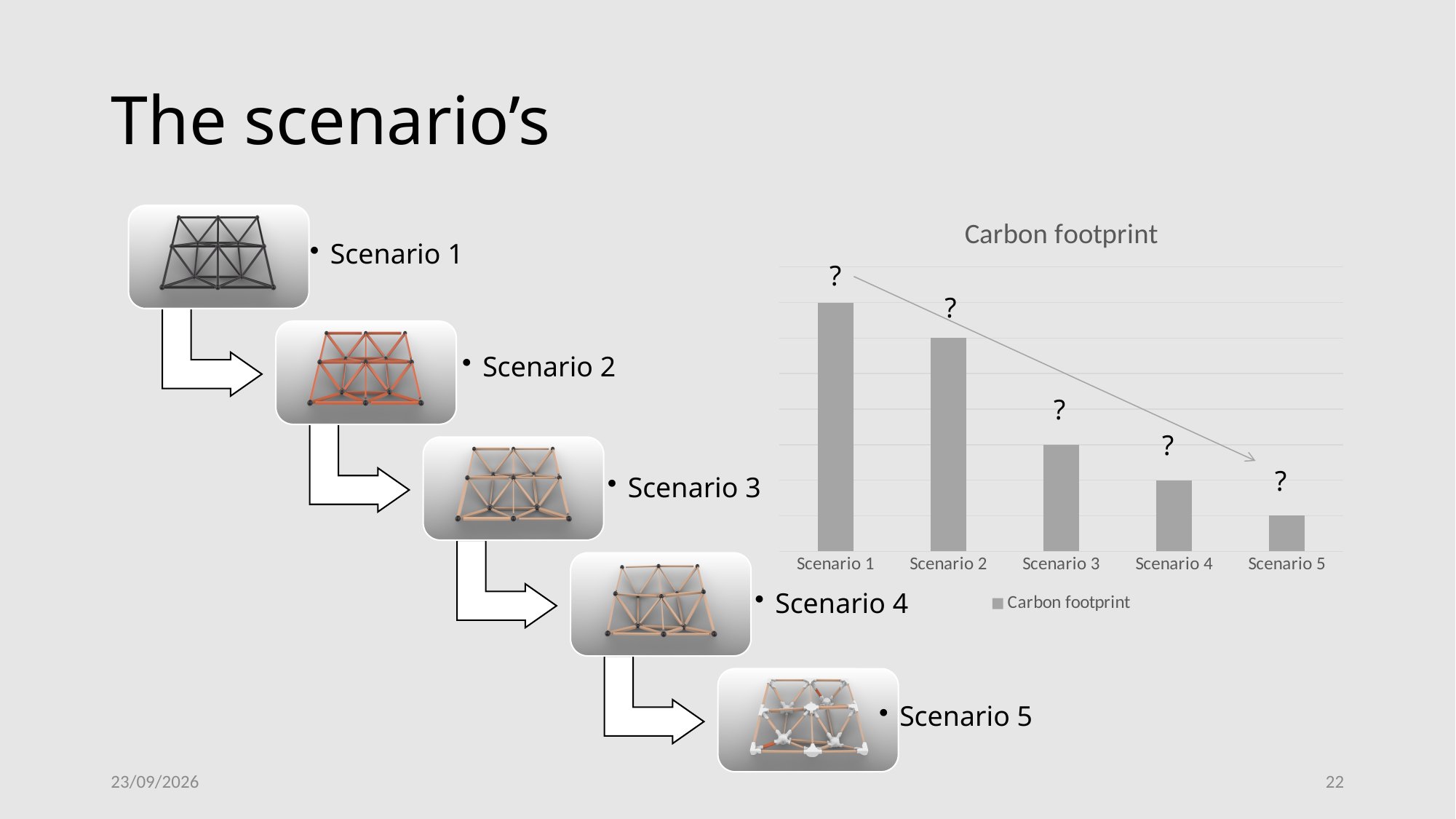
Do the carbon footprint values rise or fall from Scenario 1 to Scenario 5? fall Which has the larger carbon footprint, Scenario 4 or Scenario 5? Scenario 4 Which has the larger carbon footprint, Scenario 2 or Scenario 3? Scenario 2 What label is printed above each bar in the Carbon footprint chart instead of a value? ? What kind of chart is shown on the slide? bar chart Which has the larger carbon footprint, Scenario 1 or Scenario 4? Scenario 1 How many series does the legend of the Carbon footprint chart list? 1 How many categories are plotted in the Carbon footprint chart? 5 What is the title of the chart? Carbon footprint Which scenario has the highest carbon footprint in the chart? Scenario 1 Which scenario has the lowest carbon footprint in the chart? Scenario 5